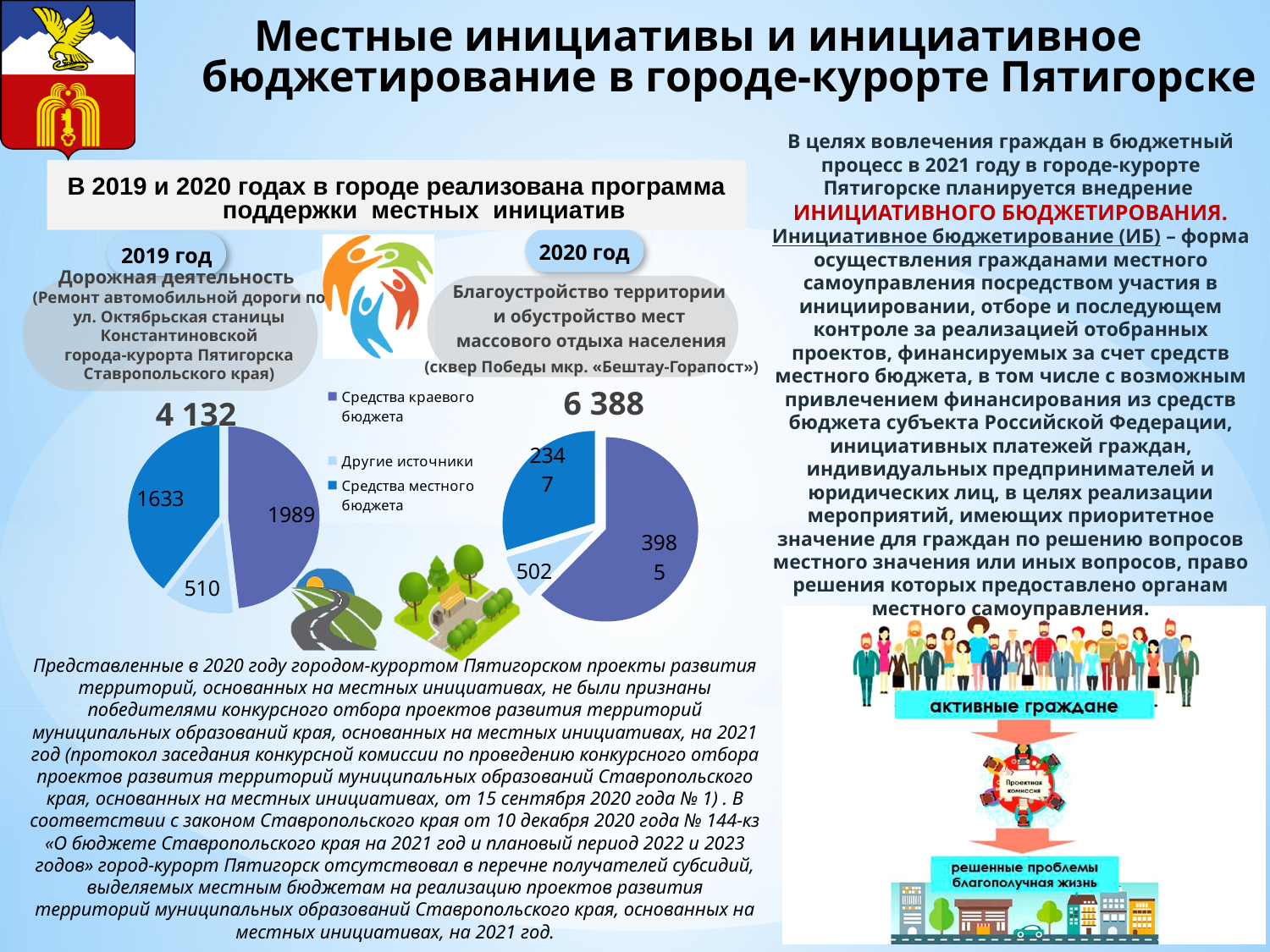
How many entries does the legend between the two pie charts list? 3 What total is printed above the 2019 год pie chart? 4 132 In the 2019 год pie chart, what is the difference between the 1989 slice and the 1633 slice? 356 In the 2020 год pie chart, what is the smallest slice value? 502 In the 2019 год pie chart, what is the smallest slice value? 510 How many slices does the 2019 год pie chart have? 3 What kind of chart is used for the 2019 год data? pie chart What is the first entry listed in the legend between the two pie charts? Средства краевого бюджета What total is printed above the 2020 год pie chart? 6 388 In the 2019 год pie chart, what is the difference between the largest slice (1989) and the smallest slice (510)? 1479 In the 2019 год pie chart, what is the largest slice value? 1989 Which pie chart has the larger total, 2019 год or 2020 год? 2020 год